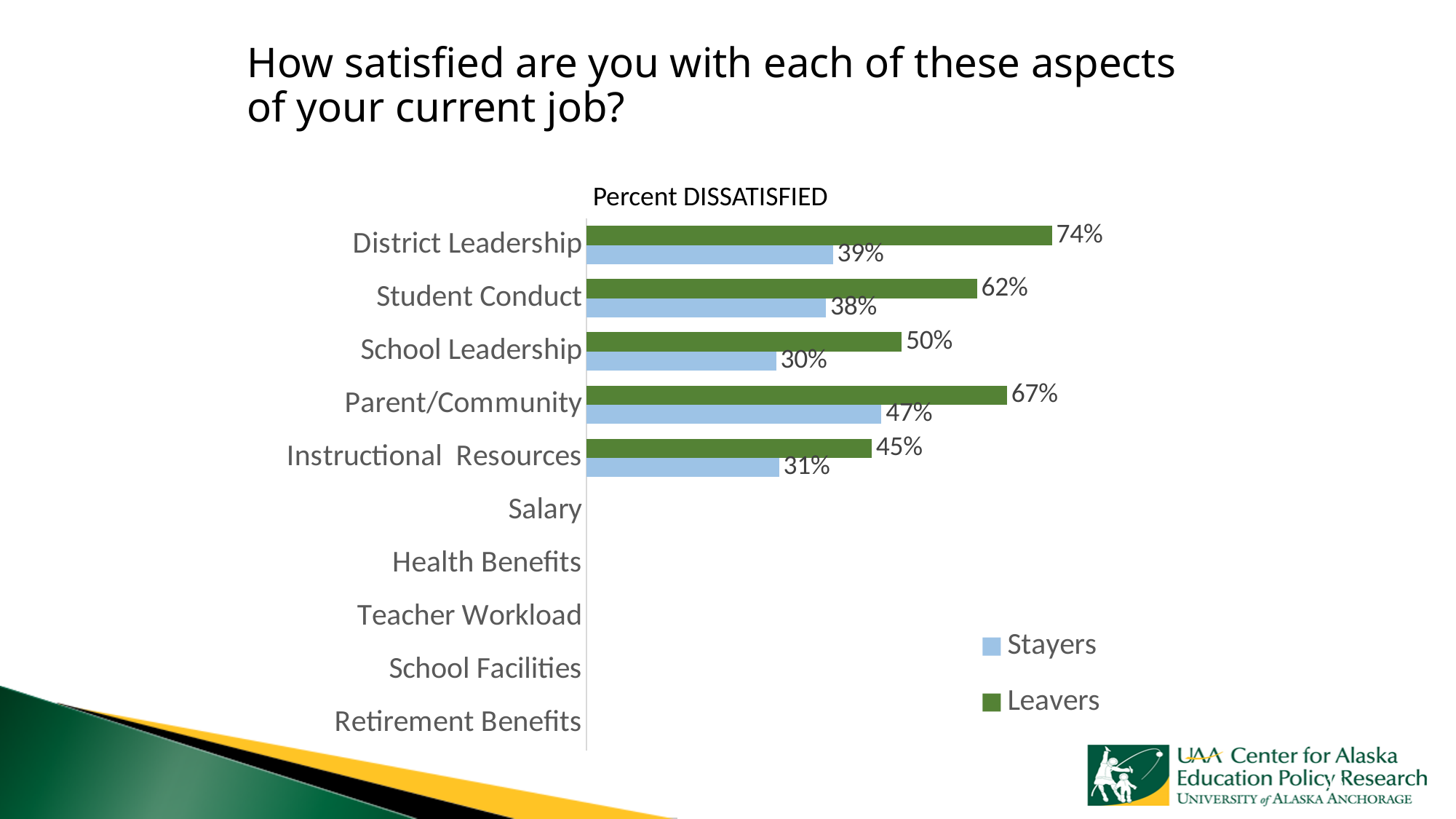
What is the Stayers value for School Leadership? 30% Which category has the highest Stayers value? Parent/Community What colour represents the Leavers series? Green Which category has the highest Leavers value? District Leadership Among the categories with bars shown, which has the lowest Leavers value? Instructional Resources What is the Leavers value for Instructional Resources? 45% How many series does the legend list? 2 What kind of chart is shown on the slide? Bar chart What percent of Stayers are dissatisfied with Parent/Community? 47% Which is larger: the Leavers value for Student Conduct or the Leavers value for Parent/Community? Parent/Community What is the difference between the Leavers and Stayers values for District Leadership? 35% What percent of Leavers are dissatisfied with District Leadership? 74%